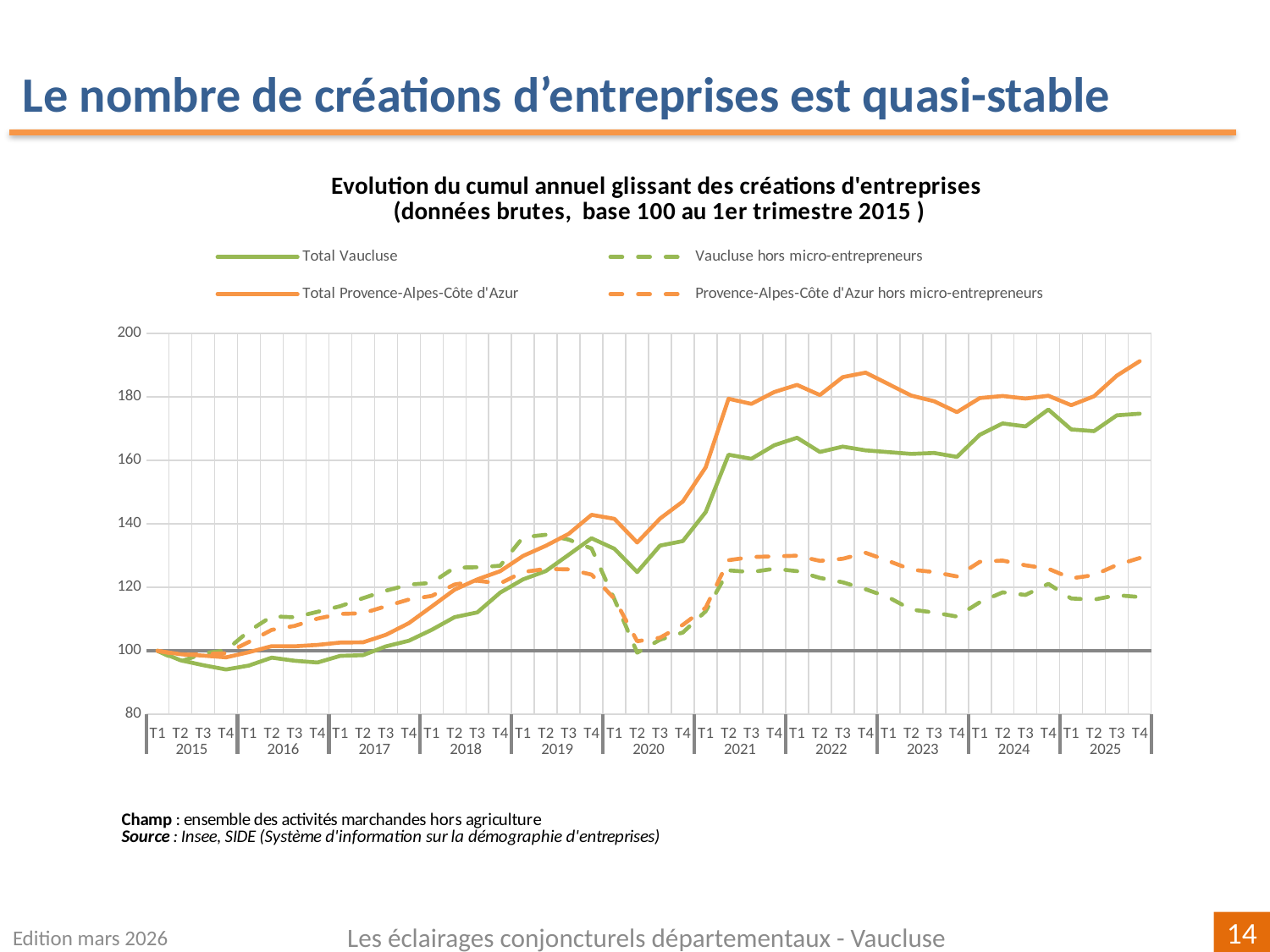
Is the value for Total Provence-Alpes-Côte d'Azur at T4 2025 greater or less than 180? greater At T4 2025, which is larger: Total Vaucluse or Total Provence-Alpes-Côte d'Azur? Total Provence-Alpes-Côte d'Azur How many series does the legend list? 4 Is the value for Provence-Alpes-Côte d'Azur hors micro-entrepreneurs at T4 2025 greater or less than 120? greater What kind of chart is shown on the slide? line chart Which series has the highest value at T4 2025? Total Provence-Alpes-Côte d'Azur Is the value for Vaucluse hors micro-entrepreneurs at T4 2025 greater or less than 120? less Does the Total Provence-Alpes-Côte d'Azur series rise or fall overall from T1 2015 to T4 2025? rise Which series has the lowest value at T4 2025? Vaucluse hors micro-entrepreneurs What is the value of every series at T1 2015, according to the chart title? 100 How many years are labelled along the x axis? 11